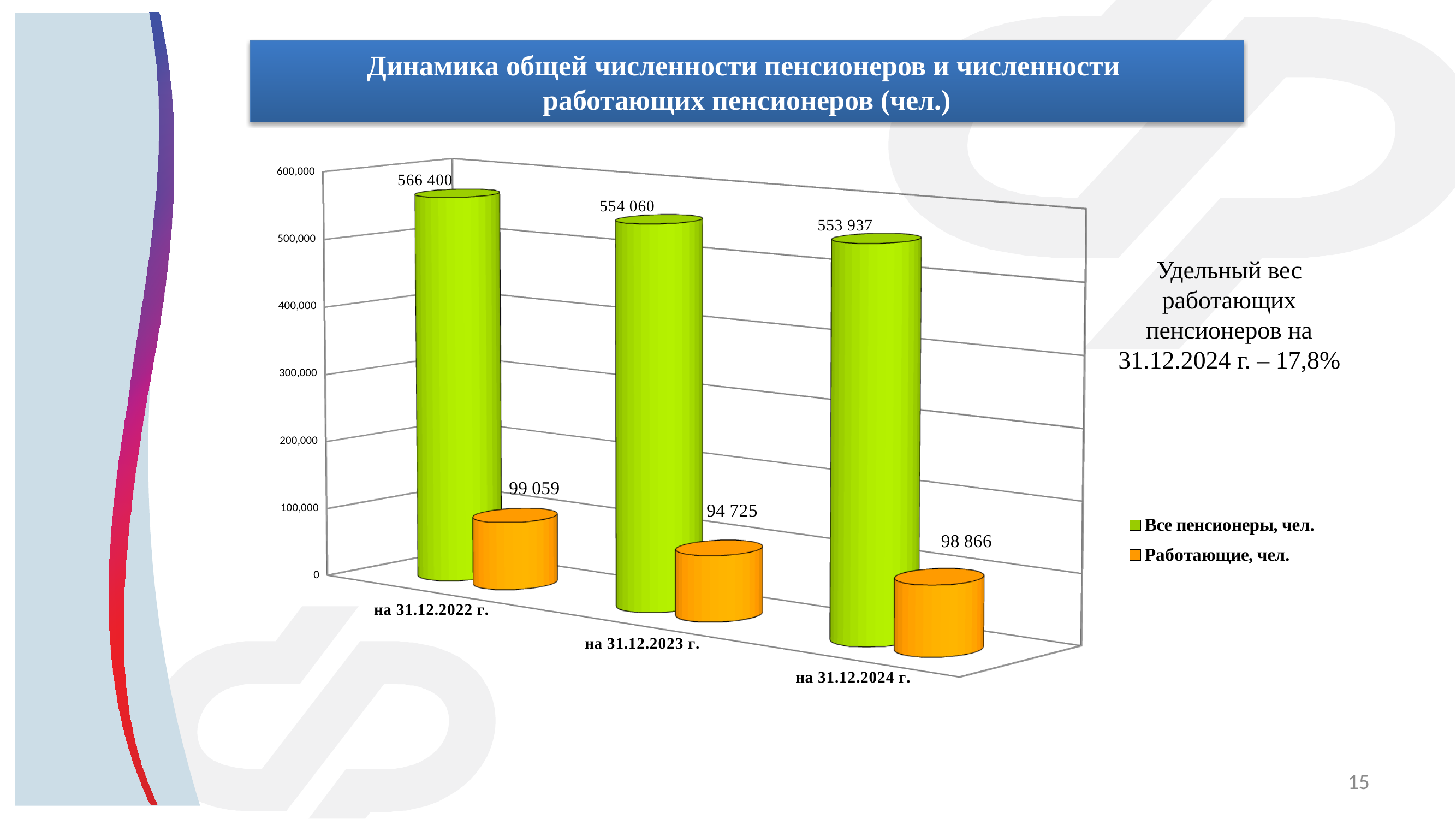
On which date is the value for "Работающие, чел." lowest? на 31.12.2023 г. Is the value for "Работающие, чел." на 31.12.2023 г. greater or less than 100,000? less What is the value for "Работающие, чел." на 31.12.2023 г.? 94 725 On which date is the value for "Работающие, чел." highest? на 31.12.2022 г. How many series does the legend list? 2 Do the values for "Все пенсионеры, чел." rise or fall from 31.12.2022 to 31.12.2024? fall What is the value for "Все пенсионеры, чел." на 31.12.2022 г.? 566 400 How many dates (categories) are shown on the x axis? 3 What is the value for "Все пенсионеры, чел." на 31.12.2024 г.? 553 937 What is the difference between the "Все пенсионеры, чел." values на 31.12.2022 г. and на 31.12.2023 г.? 12 340 Which is larger: the "Работающие, чел." value на 31.12.2022 г. or на 31.12.2024 г.? на 31.12.2022 г. What is the difference between the "Работающие, чел." values на 31.12.2024 г. and на 31.12.2023 г.? 4 141